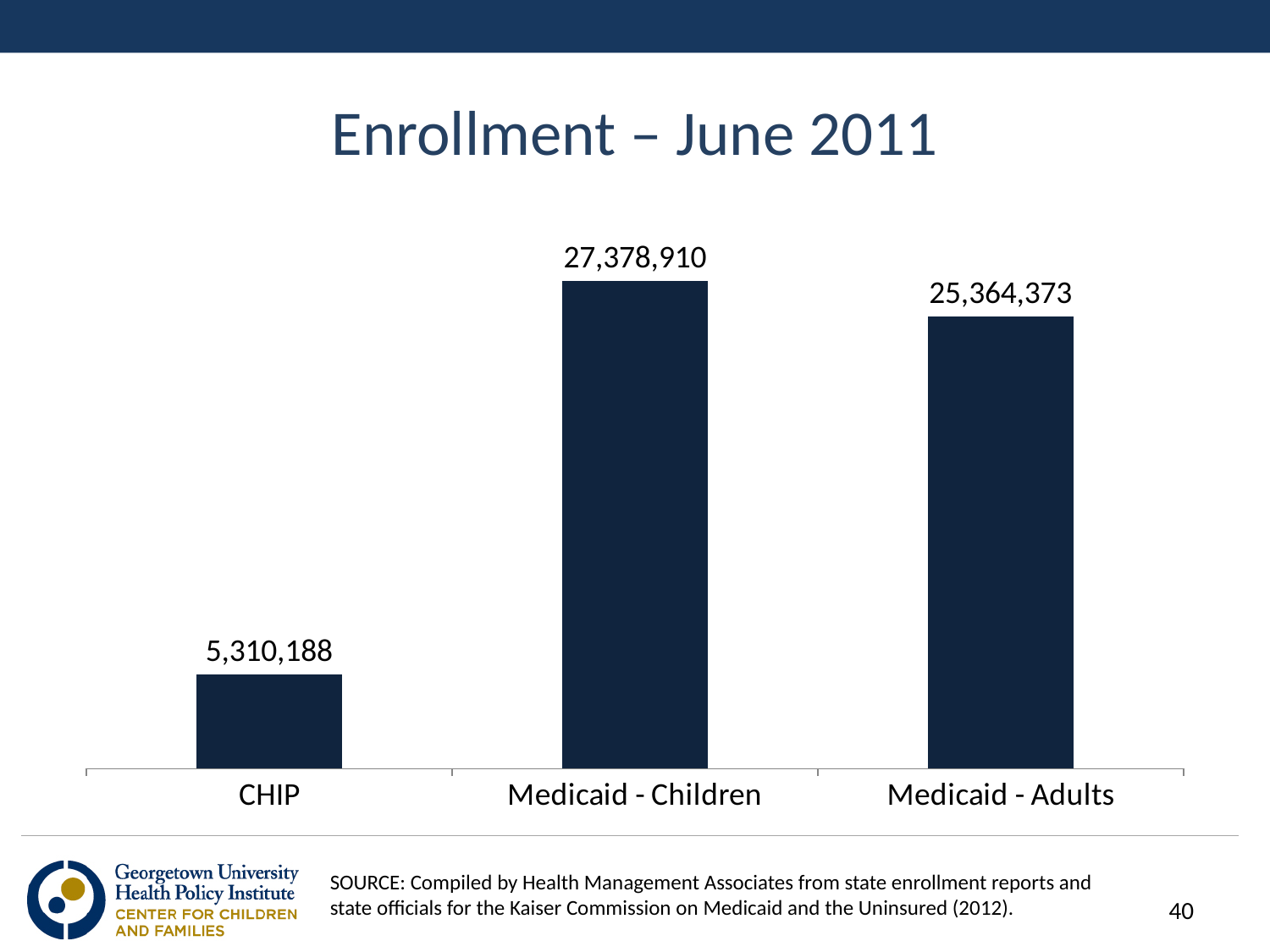
What is the difference in enrollment between Medicaid - Adults and CHIP? 20,054,185 Which category has the lowest enrollment? CHIP What is the enrollment value shown for Medicaid - Adults? 25,364,373 What kind of chart is shown on the slide? Bar chart What is the enrollment value shown for Medicaid - Children? 27,378,910 What is the difference in enrollment between Medicaid - Children and CHIP? 22,068,722 How many categories are shown in the chart? 3 Which category has the highest enrollment? Medicaid - Children Which has larger enrollment, CHIP or Medicaid - Adults? Medicaid - Adults What is the difference in enrollment between Medicaid - Children and Medicaid - Adults? 2,014,537 What is the title of the chart? Enrollment – June 2011 What is the enrollment value shown for CHIP? 5,310,188